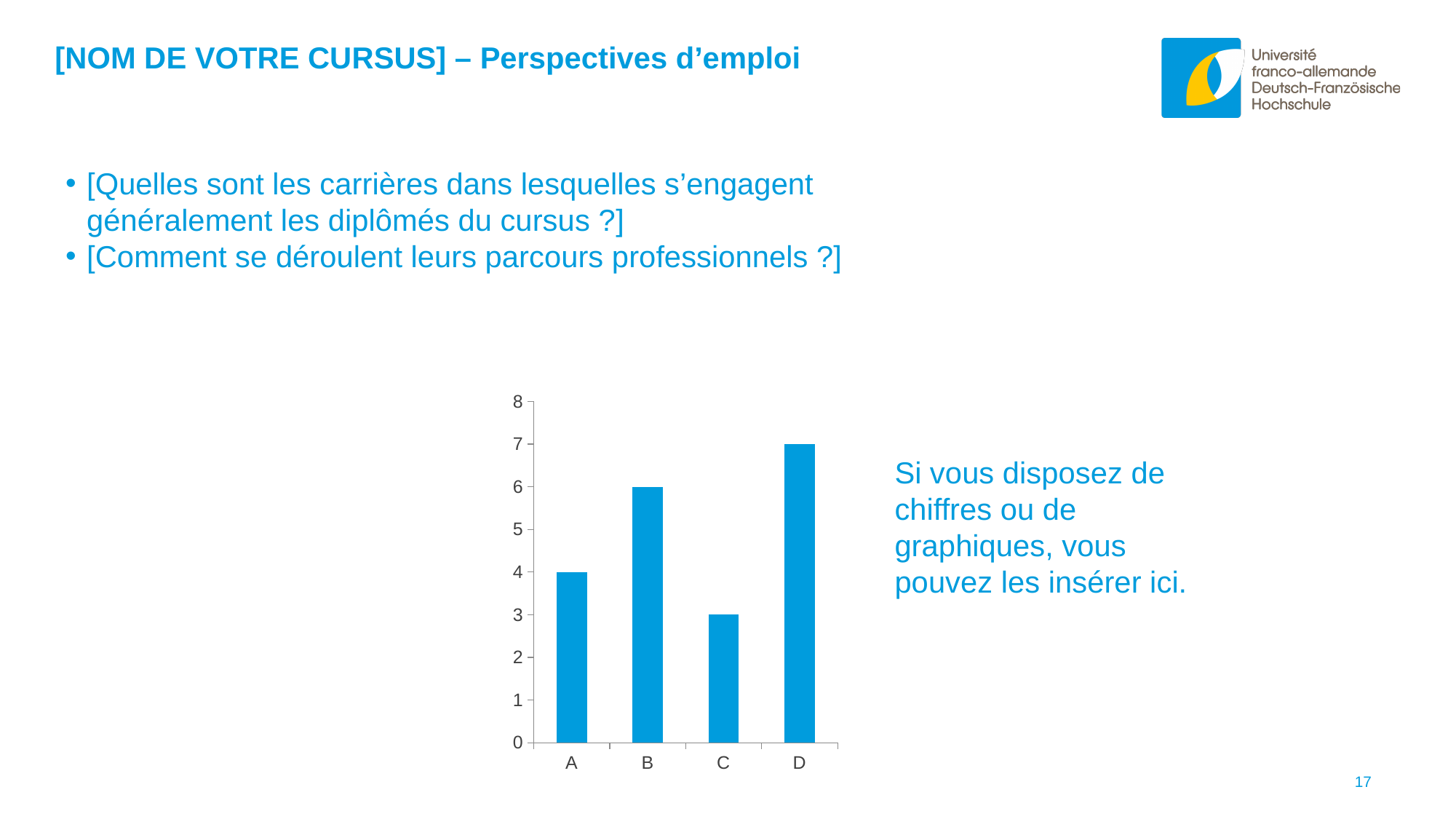
What is the value for category D? 7 Which category has the lowest value? C What is the value for category A? 4 What is the difference between the values for D and C? 4 Which category has the highest value? D What is the highest value shown on the y axis of the chart? 8 What type of chart is shown on the slide? bar chart Is the value for B greater or less than 5? greater Which is larger, the value for A or the value for B? B What is the value for category B? 6 How many categories are shown on the x axis of the chart? 4 What is the value for category C? 3